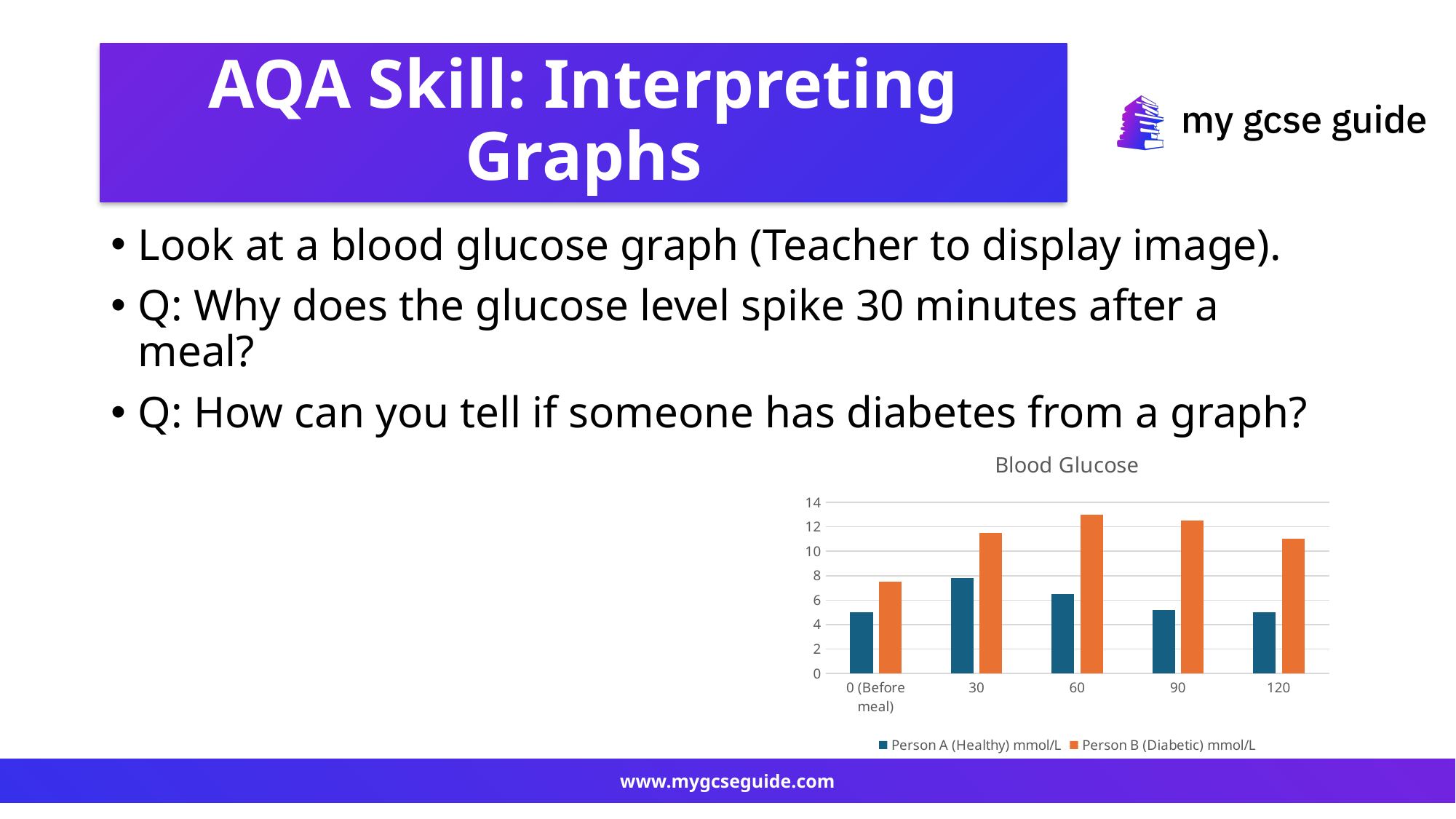
Do the values for Person B (Diabetic) mmol/L rise or fall from 60 to 120? fall At which time point is Person B (Diabetic) mmol/L lowest? 0 (Before meal) How many time categories are shown on the x axis of the chart? 5 Is the value for Person B (Diabetic) mmol/L at 120 greater or less than 10? greater What is the title of the chart? Blood Glucose Is the value for Person A (Healthy) mmol/L at 0 (Before meal) greater or less than 6? less At which time point is Person A (Healthy) mmol/L highest? 30 At 60 minutes, which is larger: Person A (Healthy) mmol/L or Person B (Diabetic) mmol/L? Person B (Diabetic) mmol/L What kind of chart is shown on the slide? bar chart At which time point is Person B (Diabetic) mmol/L highest? 60 How many series does the chart's legend list? 2 Is the value for Person B (Diabetic) mmol/L at 60 greater or less than 12? greater